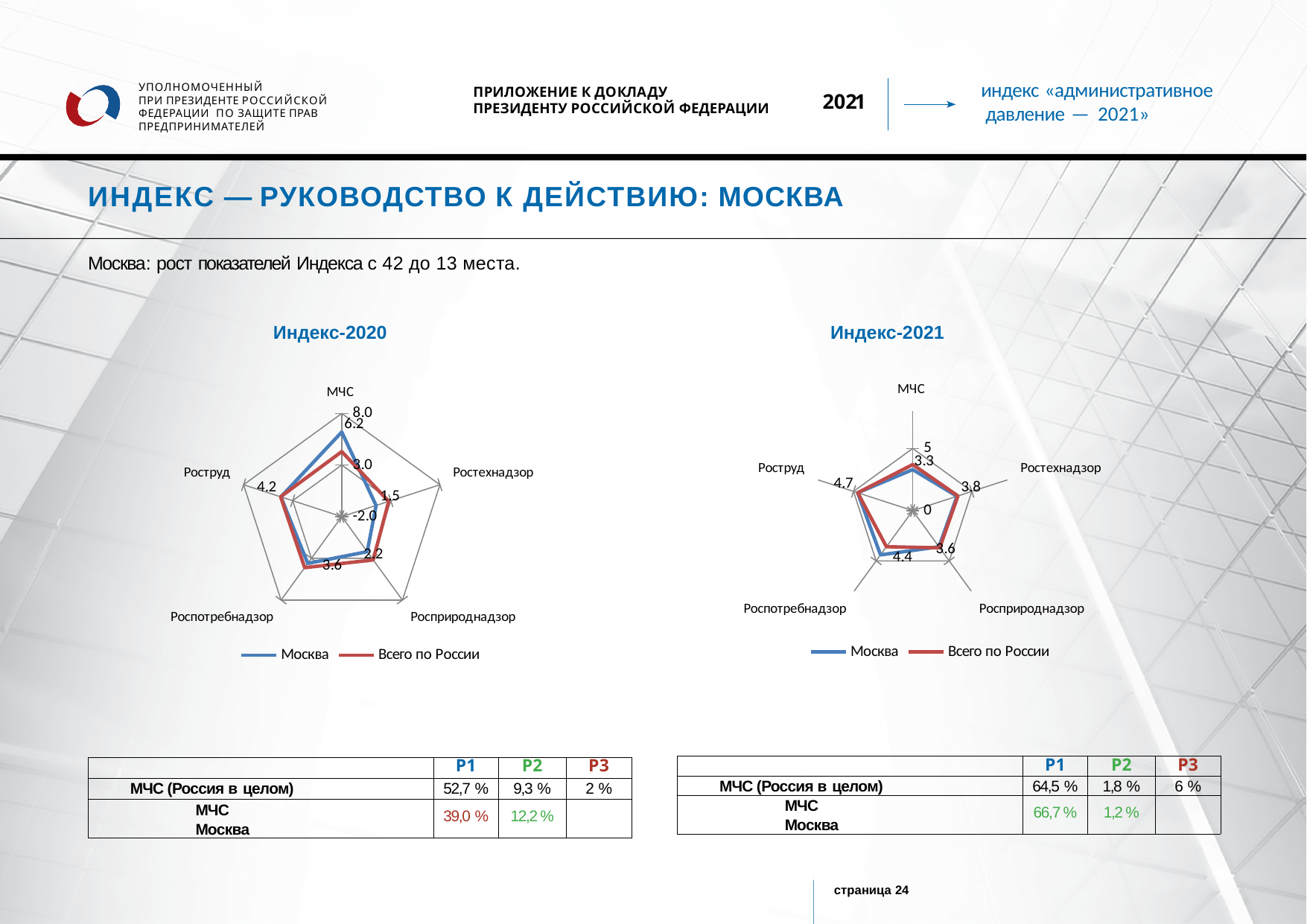
In the Индекс-2020 chart, what value is labelled for Москва on the Роструд axis? 4.2 In the Индекс-2020 chart, is the Москва value on the МЧС axis greater or less than 3.0? greater In the Индекс-2020 chart, which colour is used for the Москва series? Blue What are the two series named in the legend of the Индекс-2021 chart? Москва and Всего по России How many series does the legend of the Индекс-2020 chart list? 2 What type of chart is the Индекс-2020 chart? Radar chart In the Индекс-2020 chart, on which axis does the Москва series have its lowest value? Ростехнадзор In the Индекс-2020 chart, what value is labelled for Москва on the МЧС axis? 6.2 In the Индекс-2020 chart, on which axis does the Москва series reach its highest value? МЧС In the Индекс-2021 chart, what value is labelled for Москва on the Роструд axis? 4.7 In the Индекс-2020 chart, which is larger for Москва: the value on the МЧС axis or the value on the Роструд axis? МЧС How many categories (axes) does the Индекс-2021 radar chart have? 5